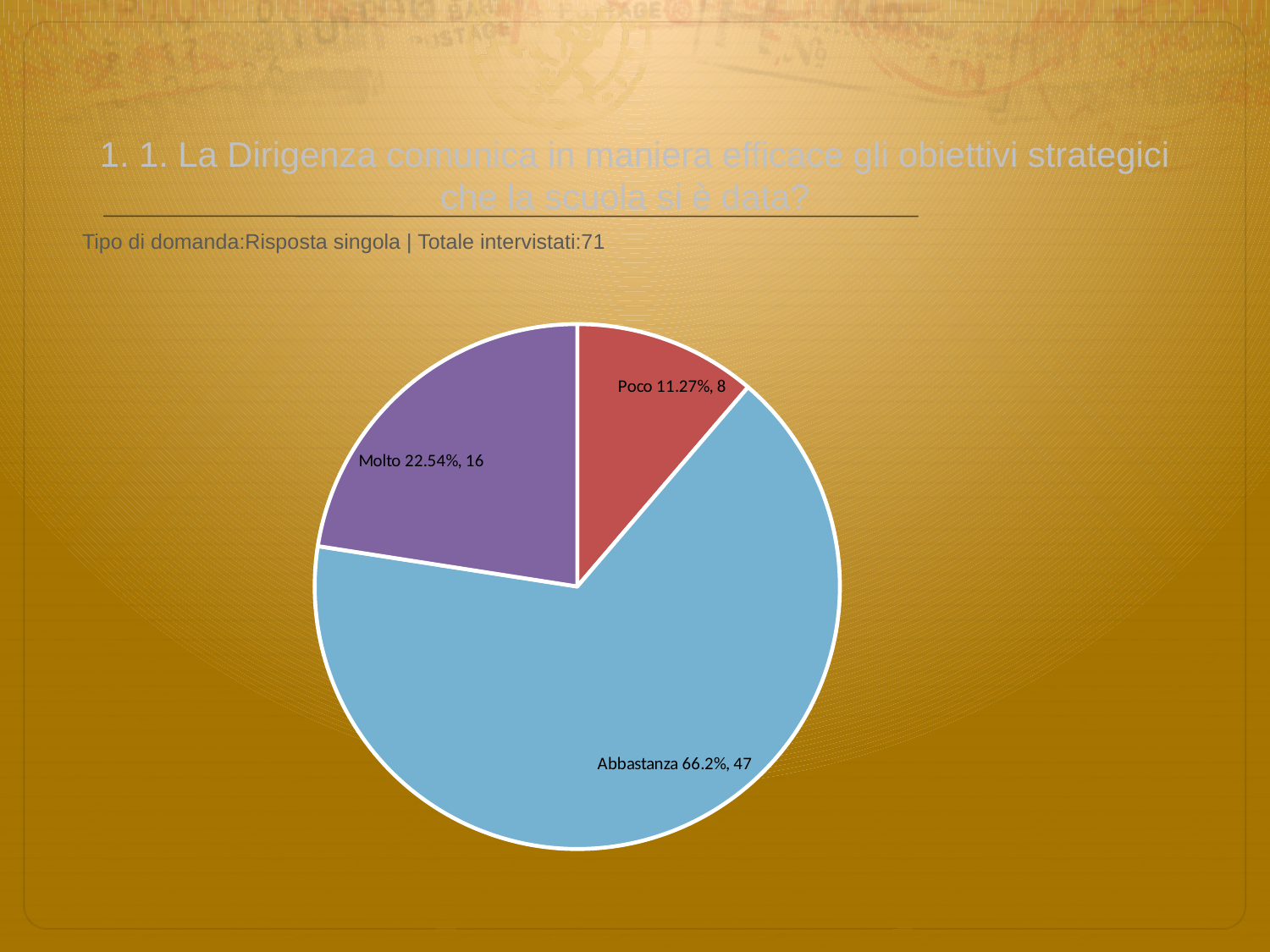
What percentage share does the Molto slice have? 22.54% How many respondents answered Abbastanza? 47 Which slice is larger, Molto or Poco? Molto Which category has the largest slice? Abbastanza How many respondents answered Molto? 16 How many respondents answered Poco? 8 Which category has the smallest slice? Poco What percentage share does the Abbastanza slice have? 66.2% How many slices does the pie chart have? 3 What is the difference in respondent count between Molto and Poco? 8 What kind of chart is shown on the slide? pie chart What percentage share does the Poco slice have? 11.27%